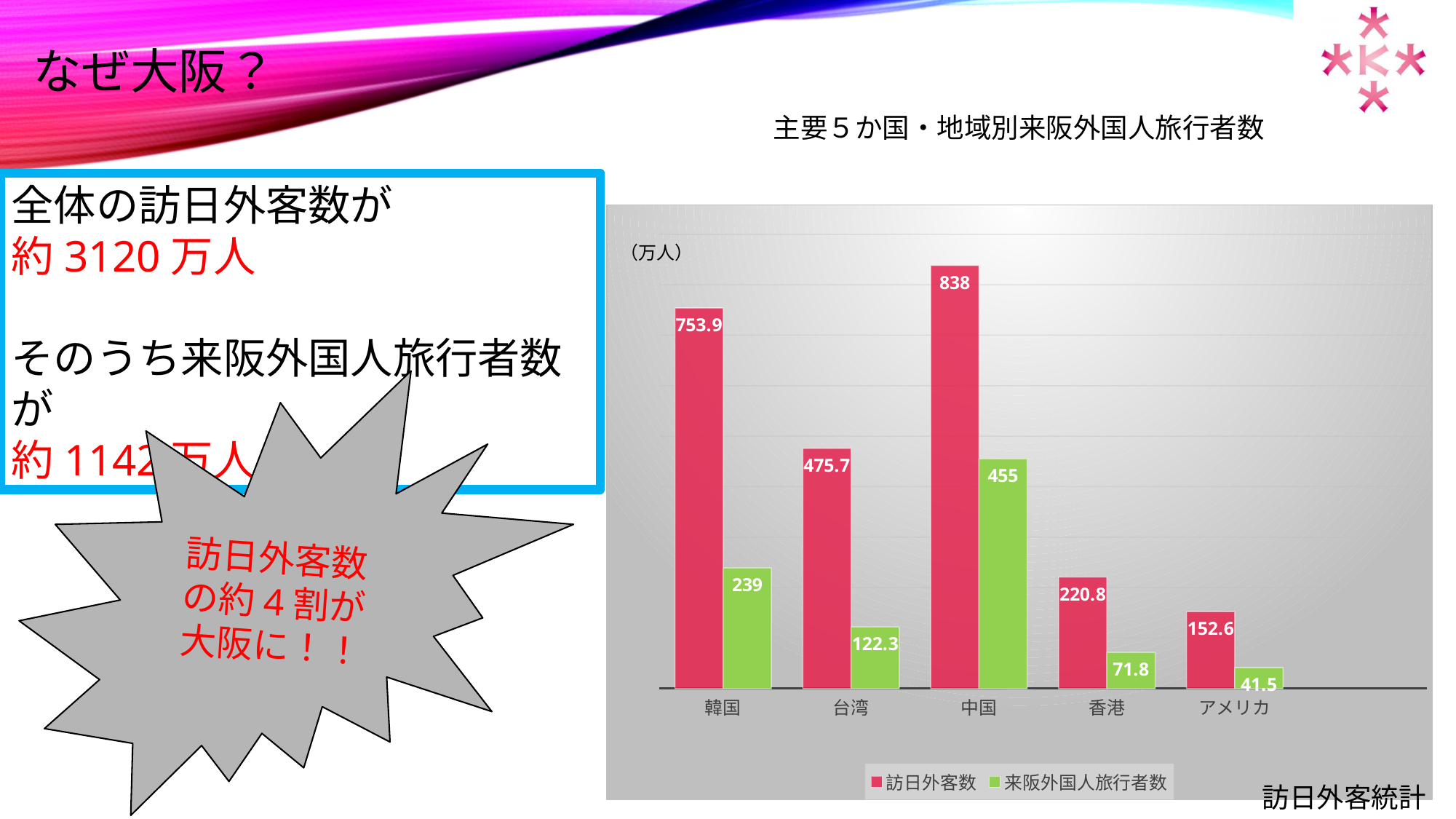
Which is larger: the 来阪外国人旅行者数 for 韓国 or for 中国? 中国 Which country or region has the lowest 来阪外国人旅行者数? アメリカ What unit is shown in the top-left corner of the chart? 万人 Which country or region has the highest 訪日外客数? 中国 What is the 来阪外国人旅行者数 value for 台湾? 122.3 What is the difference between the 訪日外客数 and 来阪外国人旅行者数 values for 香港? 149 How many series does the legend list? 2 What is the 来阪外国人旅行者数 value for 韓国? 239 What kind of chart is shown on the slide? Bar chart How many countries or regions are shown on the x axis? 5 What is the 訪日外客数 value for アメリカ? 152.6 What is the 訪日外客数 value for 中国? 838